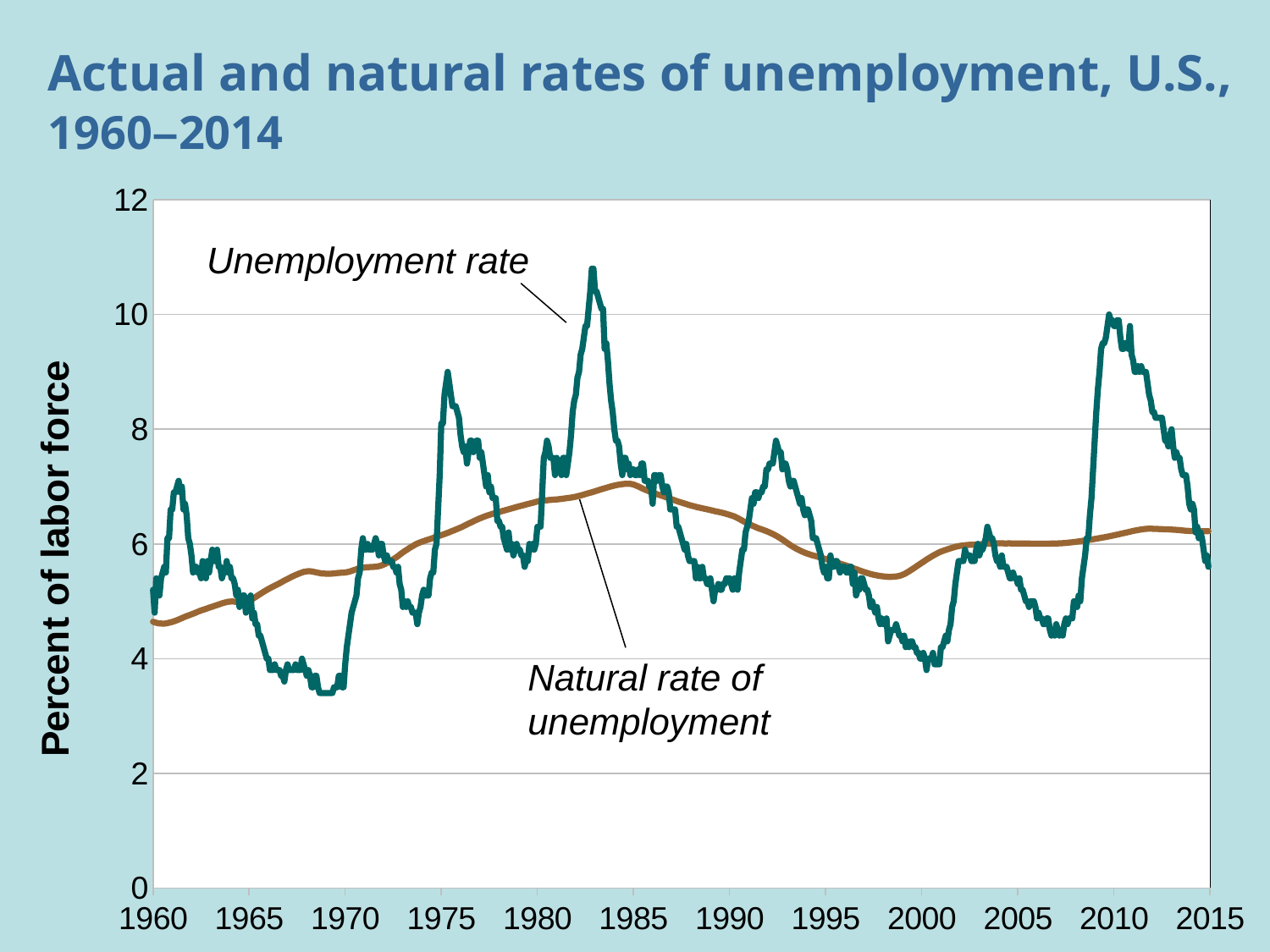
Is the natural rate of unemployment in 1960 greater or less than 6? less Is the natural rate of unemployment around 1985 greater or less than 6? greater What is the title of the chart on the slide? Actual and natural rates of unemployment, U.S., 1960–2014 Around 2000, which series is higher: the unemployment rate or the natural rate of unemployment? Natural rate of unemployment Around 1983, which series is higher: the unemployment rate or the natural rate of unemployment? Unemployment rate What kind of chart is shown on the slide? line chart Does the unemployment rate rise or fall between 2010 and 2014? fall Is the unemployment rate around 1969 greater or less than 4? less How many data series are plotted on the chart? 2 What is the label on the vertical axis of the chart? Percent of labor force Does the natural rate of unemployment rise or fall between 1960 and 1985? rise